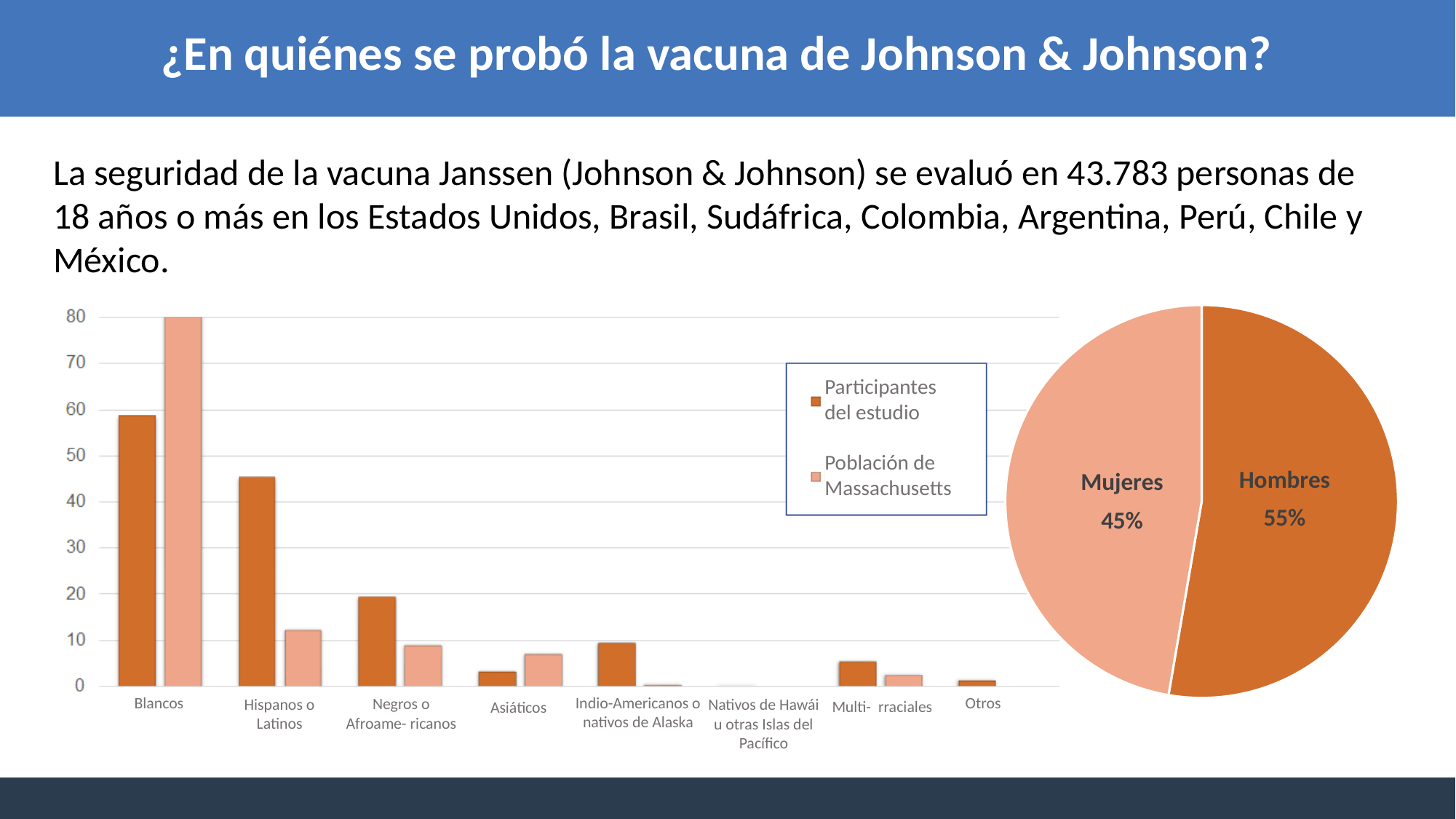
In the pie chart on the right, which slice is larger, Mujeres or Hombres? Hombres What kind of chart is the chart on the left of the slide? Bar chart In the bar chart on the left, is the value for Hispanos o Latinos in the Población de Massachusetts series greater or less than 20? less In the bar chart on the left, which category has the highest value for Participantes del estudio? Blancos In the bar chart on the left, is the value for Blancos in the Participantes del estudio series greater or less than 50? greater In the pie chart on the right, what share is labelled for Hombres? 55% In the bar chart on the left, how many series does the legend list? 2 In the bar chart on the left, which series is larger for Negros o Afroamericanos, Participantes del estudio or Población de Massachusetts? Participantes del estudio What kind of chart is the chart on the right of the slide? Pie chart In the pie chart on the right, what is the difference between the Hombres share and the Mujeres share? 10% In the bar chart on the left, how many categories are shown on the x axis? 8 In the pie chart on the right, what share is labelled for Mujeres? 45%